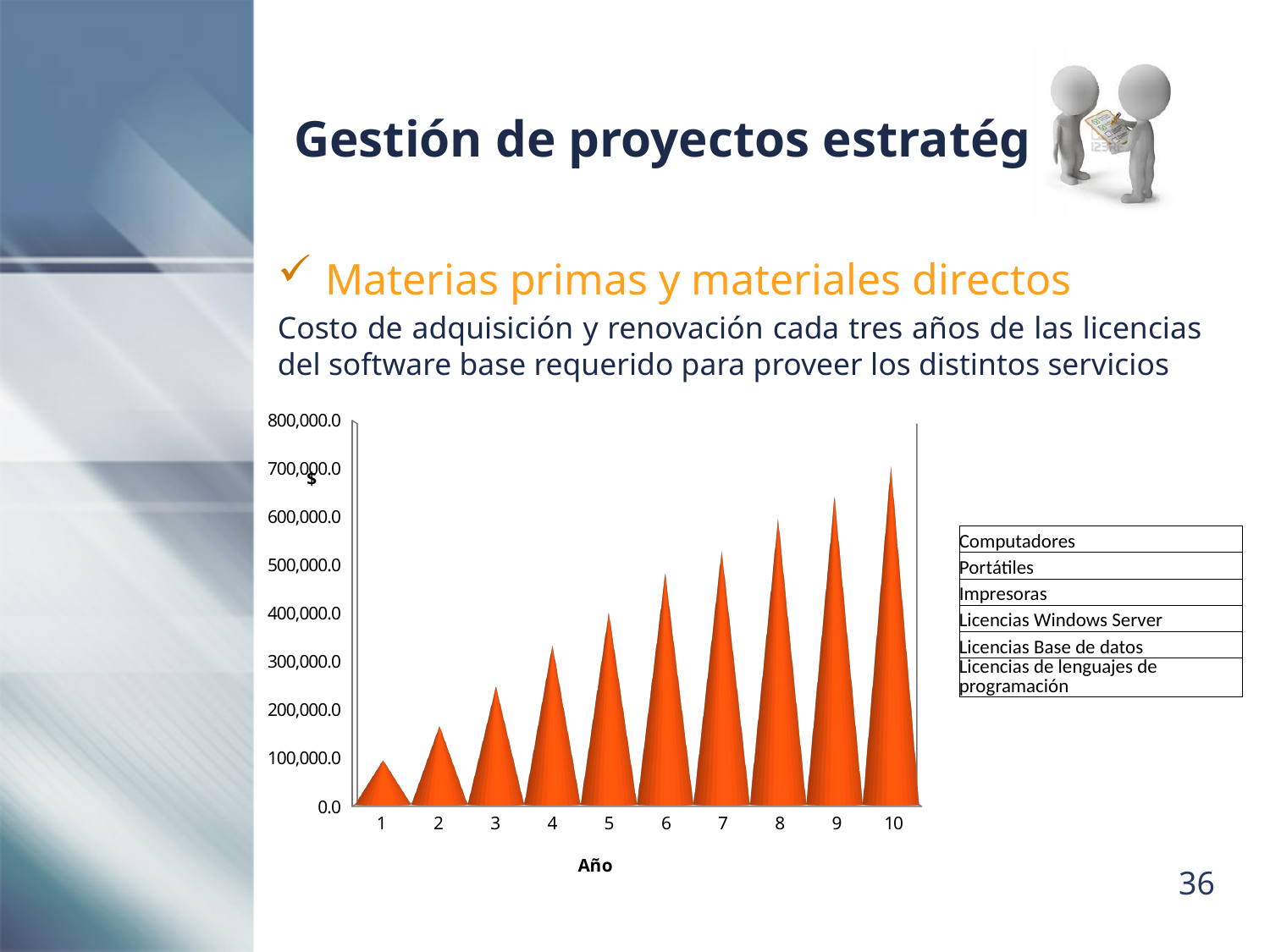
What kind of chart is shown on the slide? bar chart Which year has the highest value in the chart? 10 How many years (categories) are plotted on the x axis of the chart? 10 Do the values rise or fall from year 1 to year 10? rise Which year has the lowest value in the chart? 1 Is the value for year 10 greater or less than 600,000.0? greater Is the value for year 1 greater or less than 100,000.0? less What is the title of the x axis of the chart? Año Which is larger, the value for year 7 or the value for year 3? year 7 What is the highest tick value shown on the y axis of the chart? 800,000.0 Is the value for year 8 greater or less than 500,000.0? greater